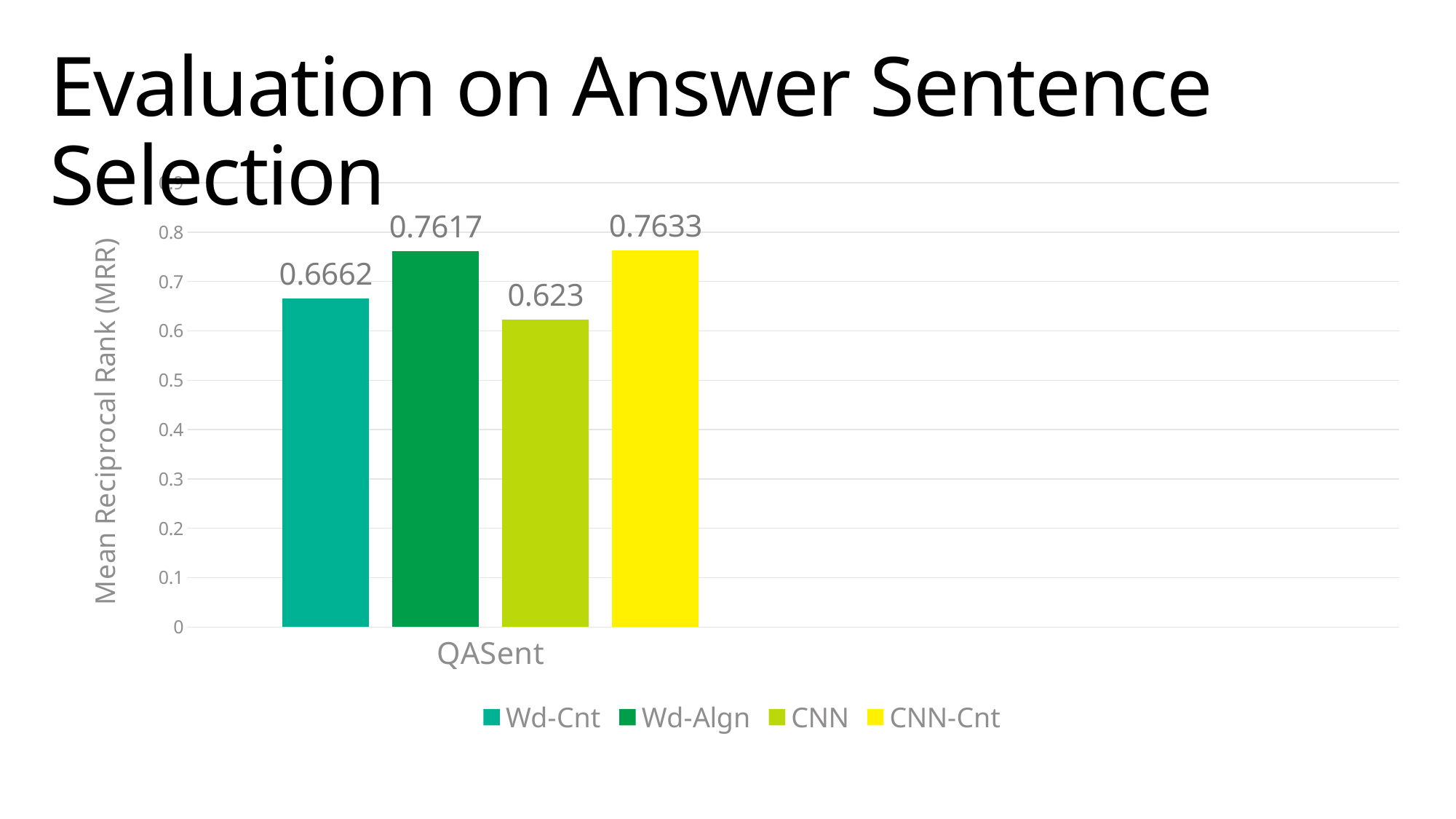
What kind of chart is shown on the slide? Bar chart How many series does the legend list? 4 Which series has the lowest MRR on QASent? CNN What is the difference in MRR between CNN-Cnt and Wd-Cnt on QASent? 0.0971 What is the Mean Reciprocal Rank (MRR) for Wd-Cnt on QASent? 0.6662 Which series has the highest MRR on QASent? CNN-Cnt What is the MRR value for CNN-Cnt on QASent? 0.7633 Which has a higher MRR on QASent, Wd-Cnt or CNN? Wd-Cnt What is the difference in MRR between Wd-Algn and CNN on QASent? 0.1387 What is the MRR value for Wd-Algn on QASent? 0.7617 What is the MRR value for CNN on QASent? 0.623 What is the label of the vertical axis? Mean Reciprocal Rank (MRR)